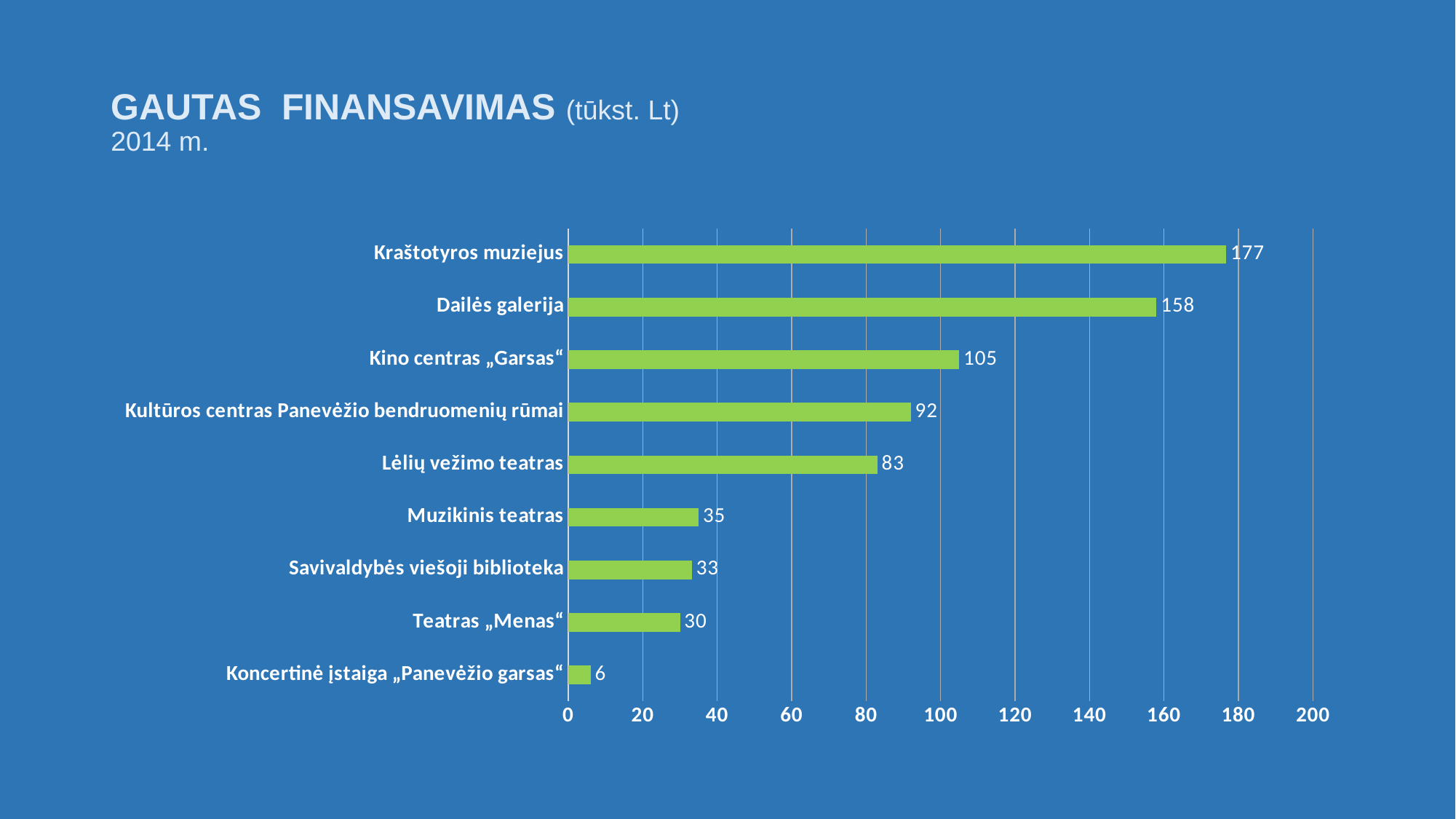
Which category has the lowest value? Koncertinė įstaiga „Panevėžio garsas“ What is the value for Kraštotyros muziejus? 177 How many categories are shown in the chart? 9 What is the value for Savivaldybės viešoji biblioteka? 33 Which is larger, the value for Muzikinis teatras or the value for Teatras „Menas“? Muzikinis teatras Is the value for Dailės galerija greater or less than 140? greater What kind of chart is shown on the slide? bar chart What is the difference between the values for Kultūros centras Panevėžio bendruomenių rūmai and Lėlių vežimo teatras? 9 What unit is given in the chart title? tūkst. Lt Which category has the highest value? Kraštotyros muziejus What is the difference between the values for Kraštotyros muziejus and Dailės galerija? 19 What is the value for Kino centras „Garsas“? 105